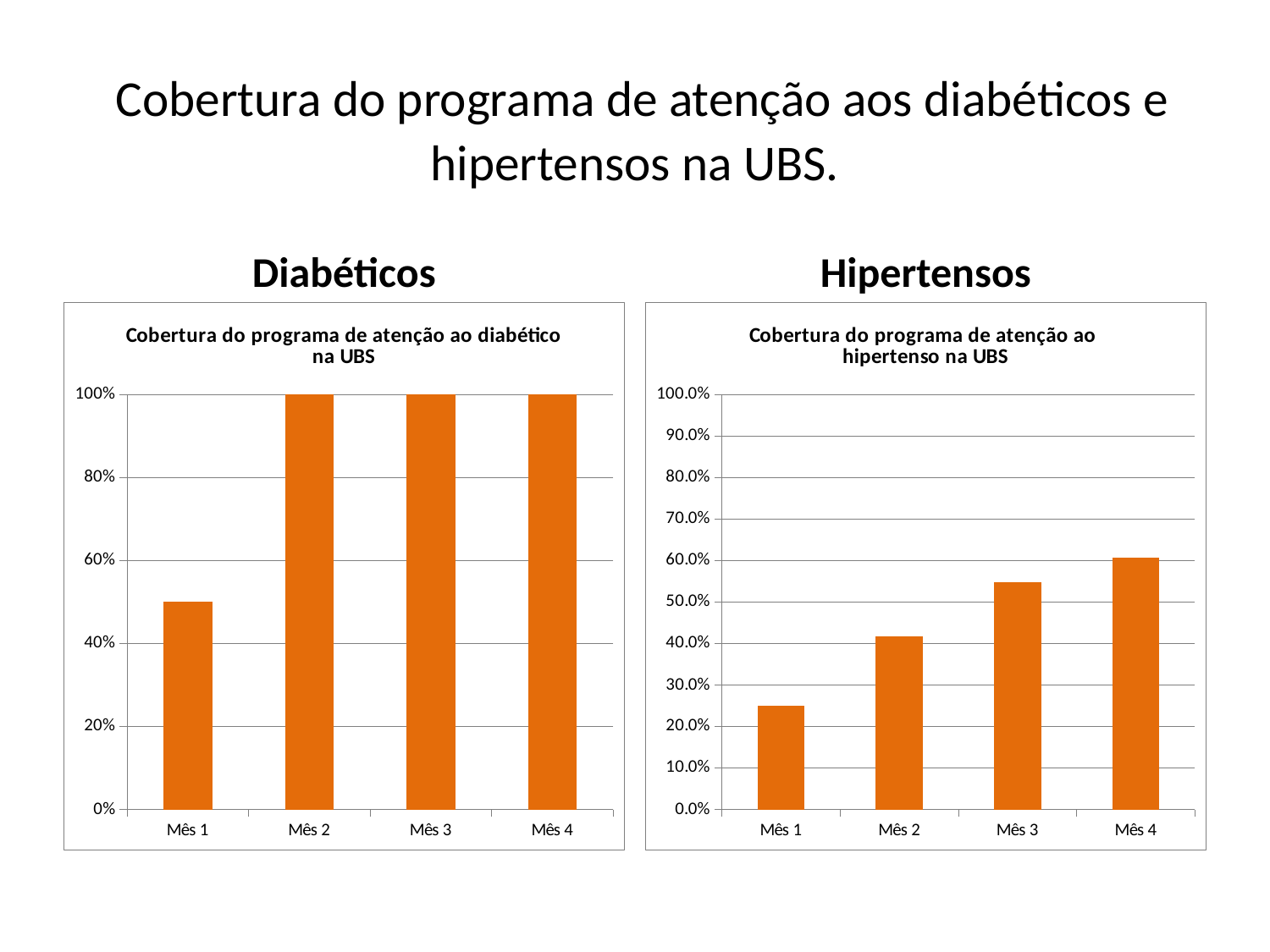
In the Diabéticos chart, what is the value for Mês 2? 100% In the Hipertensos chart, is the value for Mês 4 greater or less than 50.0%? greater In the Diabéticos chart, is the value for Mês 1 greater or less than 60%? less In the Hipertensos chart, which month has the lowest value? Mês 1 In the Hipertensos chart, which month has the highest value? Mês 4 What kind of chart is the Hipertensos chart? bar chart In the Diabéticos chart, which month has the lowest value? Mês 1 In the Hipertensos chart, do the values rise or fall from Mês 1 to Mês 4? rise In the Hipertensos chart, which is larger, the value for Mês 2 or the value for Mês 3? Mês 3 In the Hipertensos chart, is the value for Mês 1 greater or less than 30.0%? less How many months are shown on the x axis of the Diabéticos chart? 4